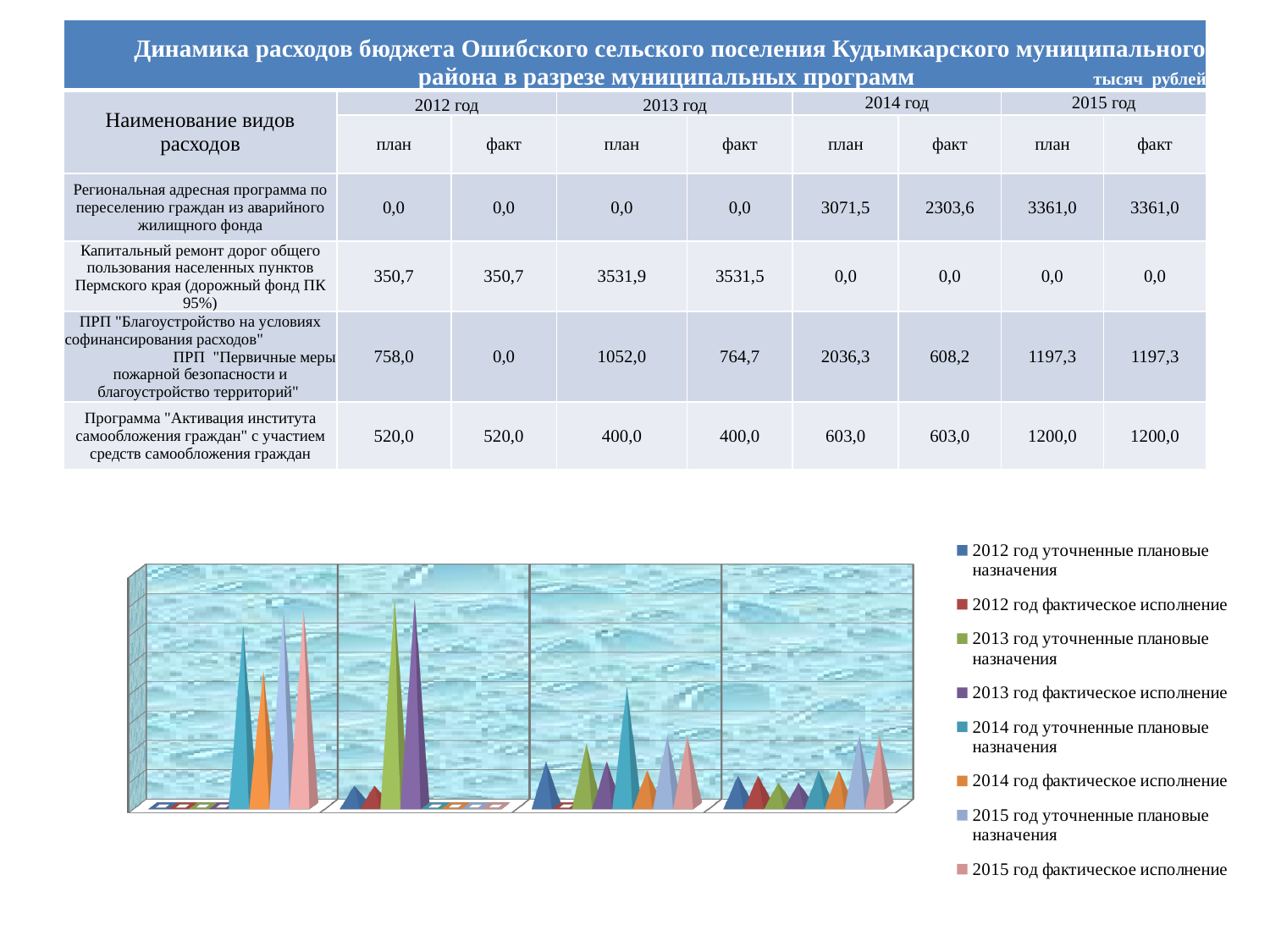
What is the first entry in the chart legend? 2012 год уточненные плановые назначения How many groups of bars are plotted along the x axis of the chart? 4 In the third group of bars from the left, which series has the tallest bar? 2014 год уточненные плановые назначения What kind of chart is shown on the slide? bar chart In the third group of bars from the left, which is larger: the bar for 2014 год уточненные плановые назначения or the bar for 2014 год фактическое исполнение? 2014 год уточненные плановые назначения In the second group of bars from the left, which is larger: the bar for 2013 год уточненные плановые назначения or the bar for 2012 год фактическое исполнение? 2013 год уточненные плановые назначения What is the last entry in the chart legend? 2015 год фактическое исполнение How many series does the chart legend list? 8